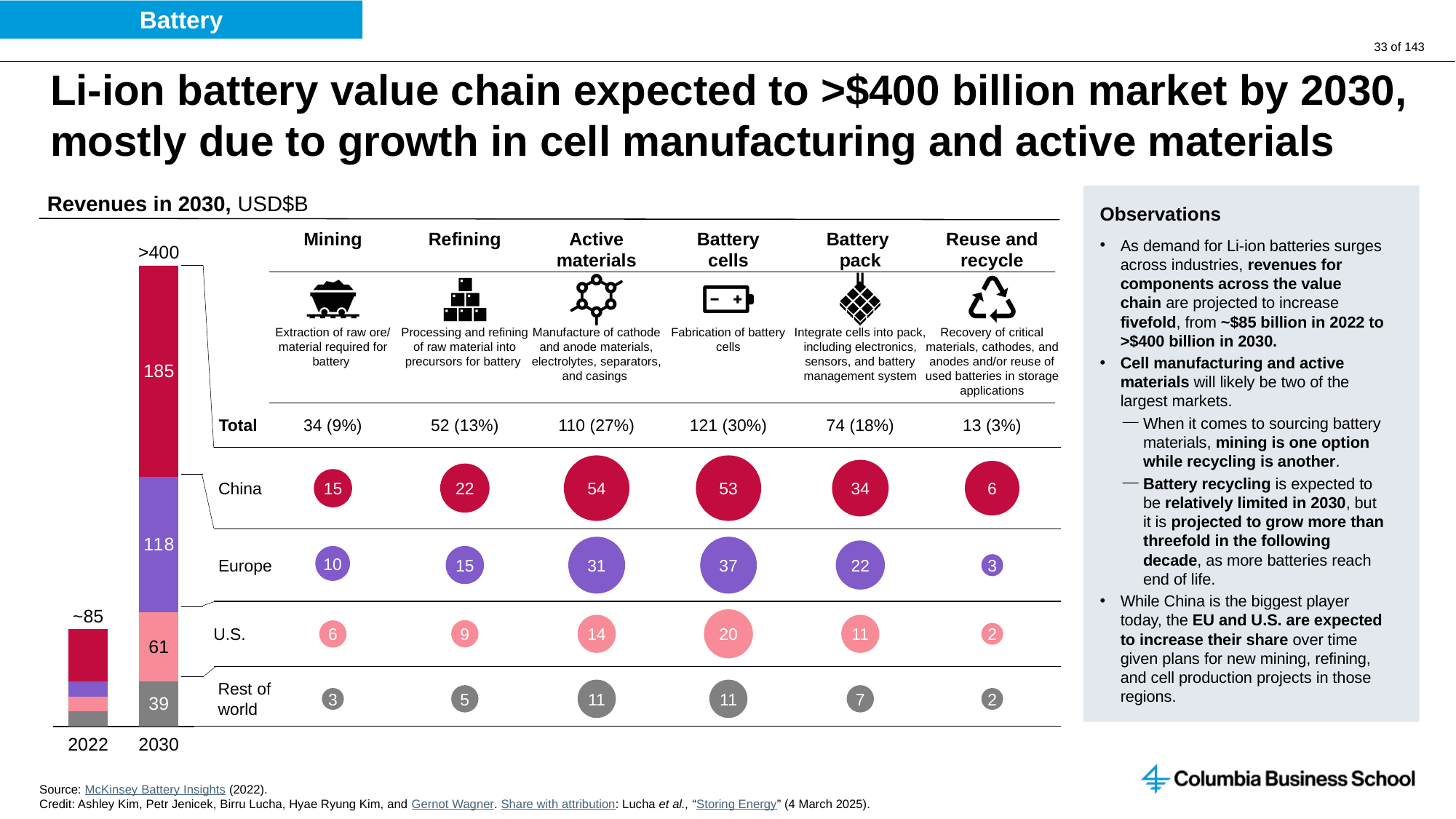
How many value chain stages are shown as columns in the bubble matrix? 6 In the bubble matrix, what is the U.S. value for Active materials? 14 Do total revenues rise or fall from 2022 to 2030 in the stacked bar chart? Rise In the stacked bar chart, what is the difference between China's and Europe's 2030 revenue? 67 In the bubble matrix, which is larger: the U.S. value for Battery cells or the Europe value for Mining? U.S. value for Battery cells In the stacked bar chart, what is China's projected revenue in 2030? 185 What share of total 2030 revenue does Battery pack account for? 18% Which value chain stage has the highest total revenue in 2030? Battery cells What kind of chart shows the 2022 and 2030 revenues on the left? Stacked bar chart In the stacked bar chart, what is the Rest of world segment value for 2030? 39 In the bubble matrix, what is Europe's value for Battery cells? 37 Which value chain stage has the lowest total revenue in 2030? Reuse and recycle